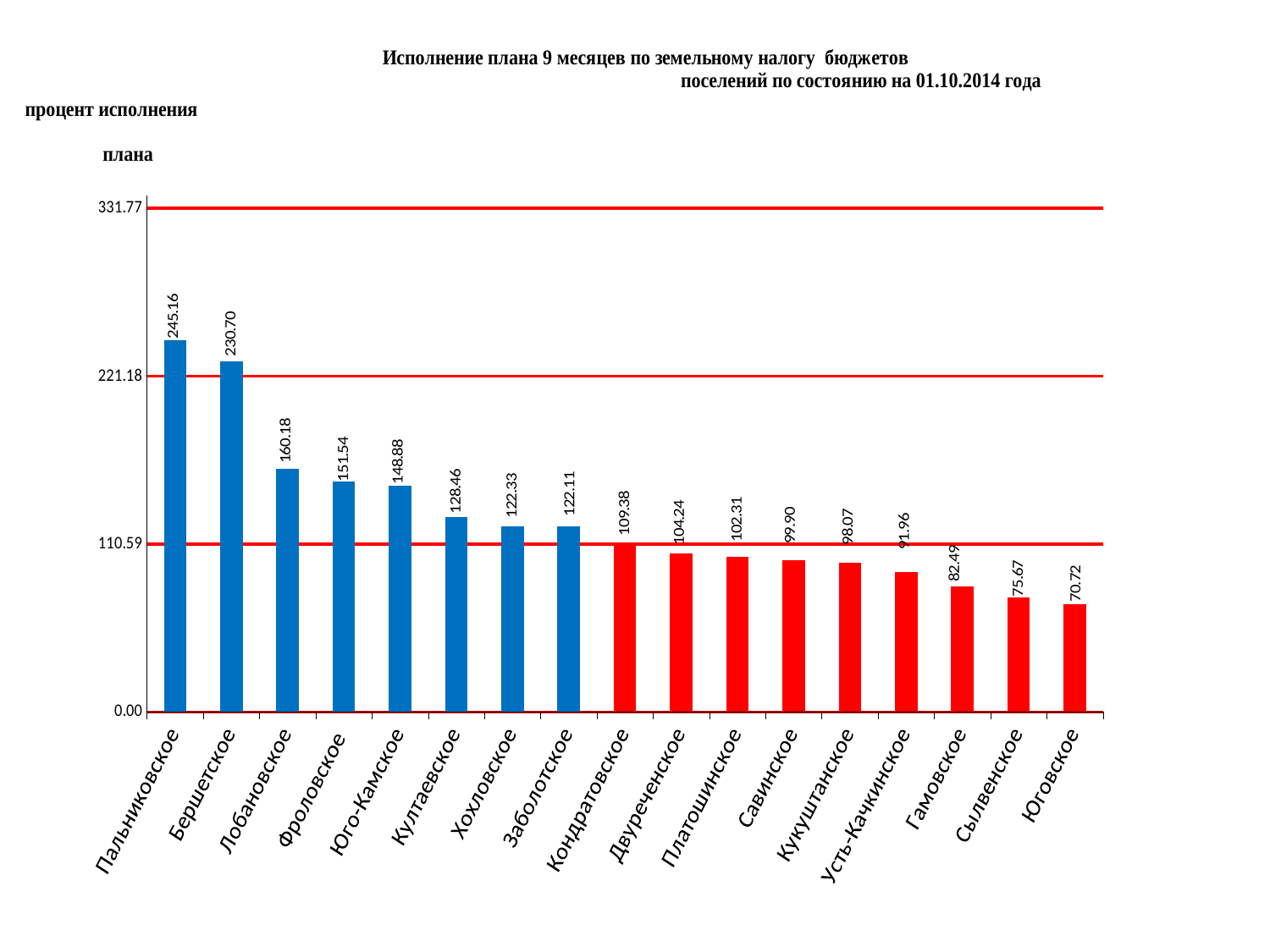
Do the values rise or fall from left to right along the x axis? Fall What is the value for Пальниковское? 245.16 What is the difference between the values for Лобановское and Фроловское? 8.64 Which category has the highest value? Пальниковское What is the value for Юговское? 70.72 What is the value for Усть-Качкинское? 91.96 Which category has the lowest value? Юговское What kind of chart is this? Bar chart What is the difference between the values for Пальниковское and Бершетское? 14.46 Which is larger, the value for Гамовское or the value for Сылвенское? Гамовское How many categories are shown on the x axis? 17 What is the value for Кондратовское? 109.38